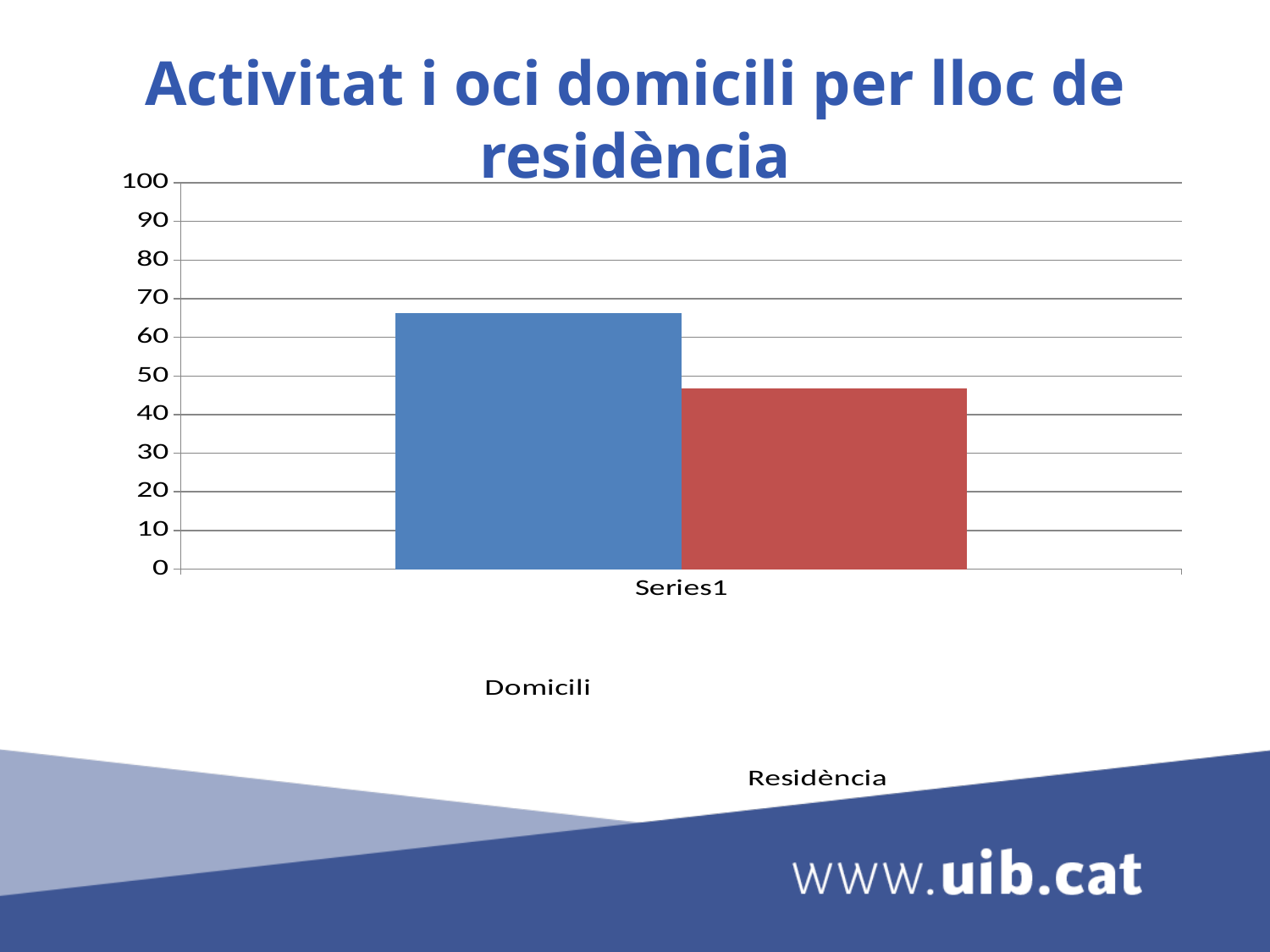
Is the value for Residència greater or less than 50? less Is the value for Domicili greater or less than 70? less How many bars are plotted in the chart? 2 What kind of chart is shown on the slide? bar chart How many series does the legend list? 2 Is the value for Residència greater or less than 40? greater Is the value for Domicili larger or smaller than the value for Residència? larger What colour is the bar for Residència? red What is the title of the chart on the slide? Activitat i oci domicili per lloc de residència Which series has the lowest value, Domicili or Residència? Residència Which series has the highest value, Domicili or Residència? Domicili